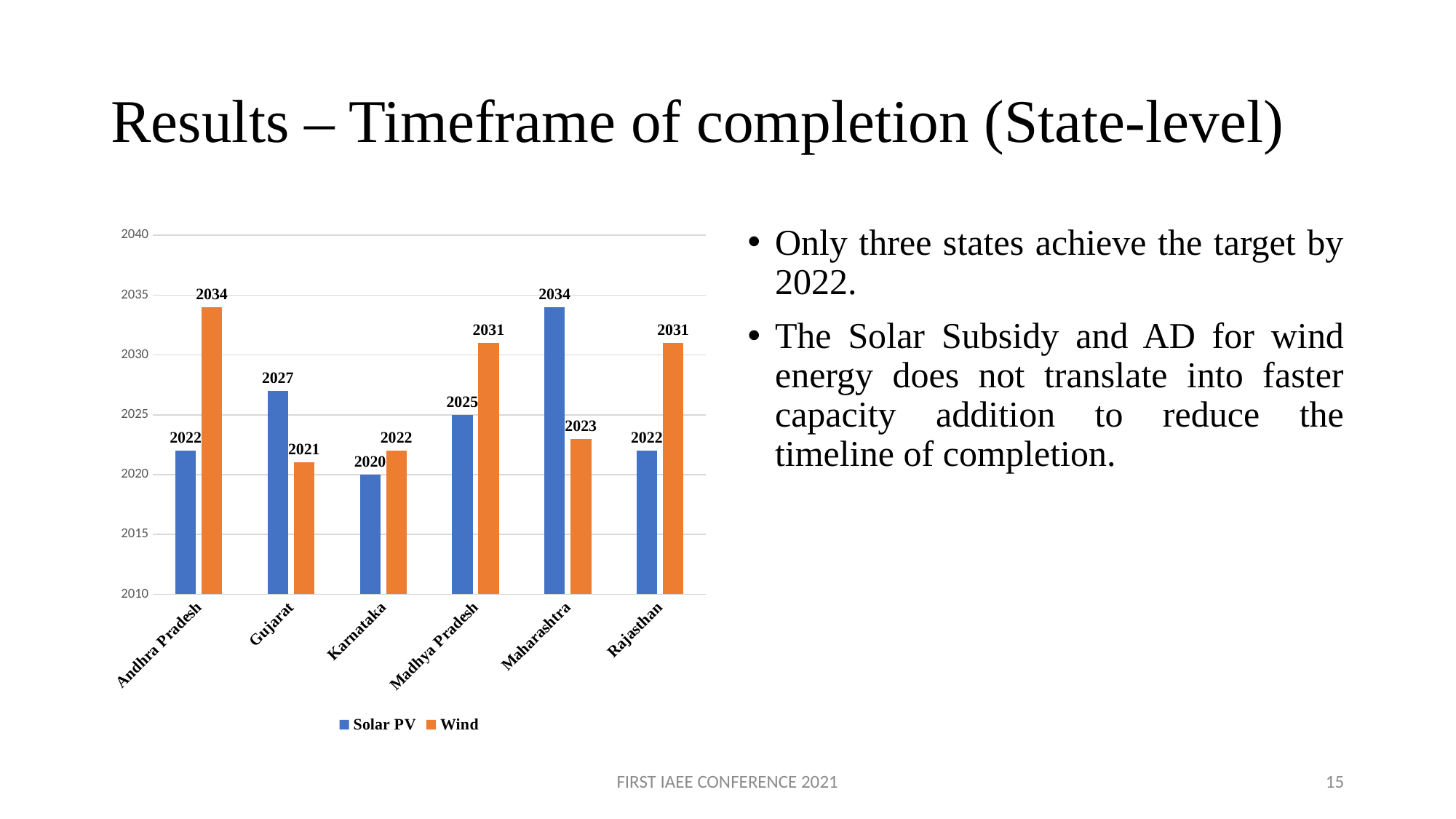
What kind of chart is shown on the slide? Bar chart How many series does the legend list? 2 Which is larger for Maharashtra, the Solar PV value or the Wind value? Solar PV How many states are shown on the x axis? 6 What is the Wind value for Karnataka? 2022 Which state has the lowest Solar PV value? Karnataka What is the Wind value for Madhya Pradesh? 2031 Which state has the lowest Wind value? Gujarat Which state has the highest Solar PV value? Maharashtra What colour are the Wind bars? Orange What is the difference between the Wind and Solar PV values for Andhra Pradesh? 12 What is the Solar PV value for Gujarat? 2027